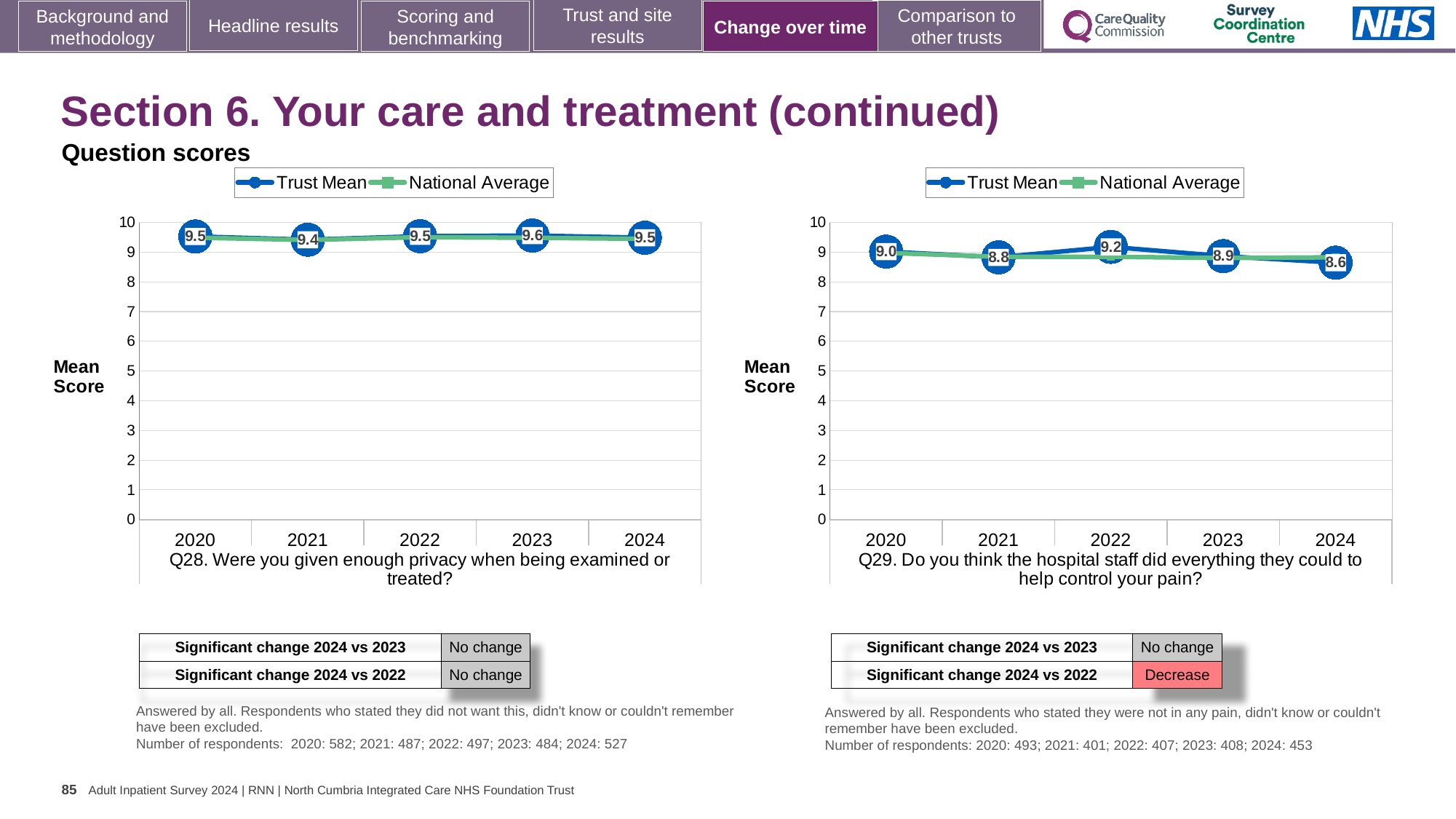
In the Q29 chart (right), is the Trust Mean value for 2024 greater or less than 9? less In the Q29 chart (right), what is the Trust Mean score for 2020? 9.0 In the Q28 chart (left), which is larger, the Trust Mean score for 2021 or for 2023? 2023 How many series does the legend of the Q29 chart (right) list? 2 In the Q29 chart (right), what is the difference between the Trust Mean scores for 2022 and 2024? 0.6 What kind of chart is the Q28 chart (left)? Line chart In the Q29 chart (right), which year has the highest Trust Mean score? 2022 How many years are plotted on the x axis of the Q28 chart (left)? 5 In the Q28 chart (left), which year has the lowest Trust Mean score? 2021 In the Q29 chart (right), which year has the lowest Trust Mean score? 2024 In the Q29 chart (right), what is the Trust Mean score for 2024? 8.6 In the Q28 chart (left), what is the Trust Mean score for 2023? 9.6